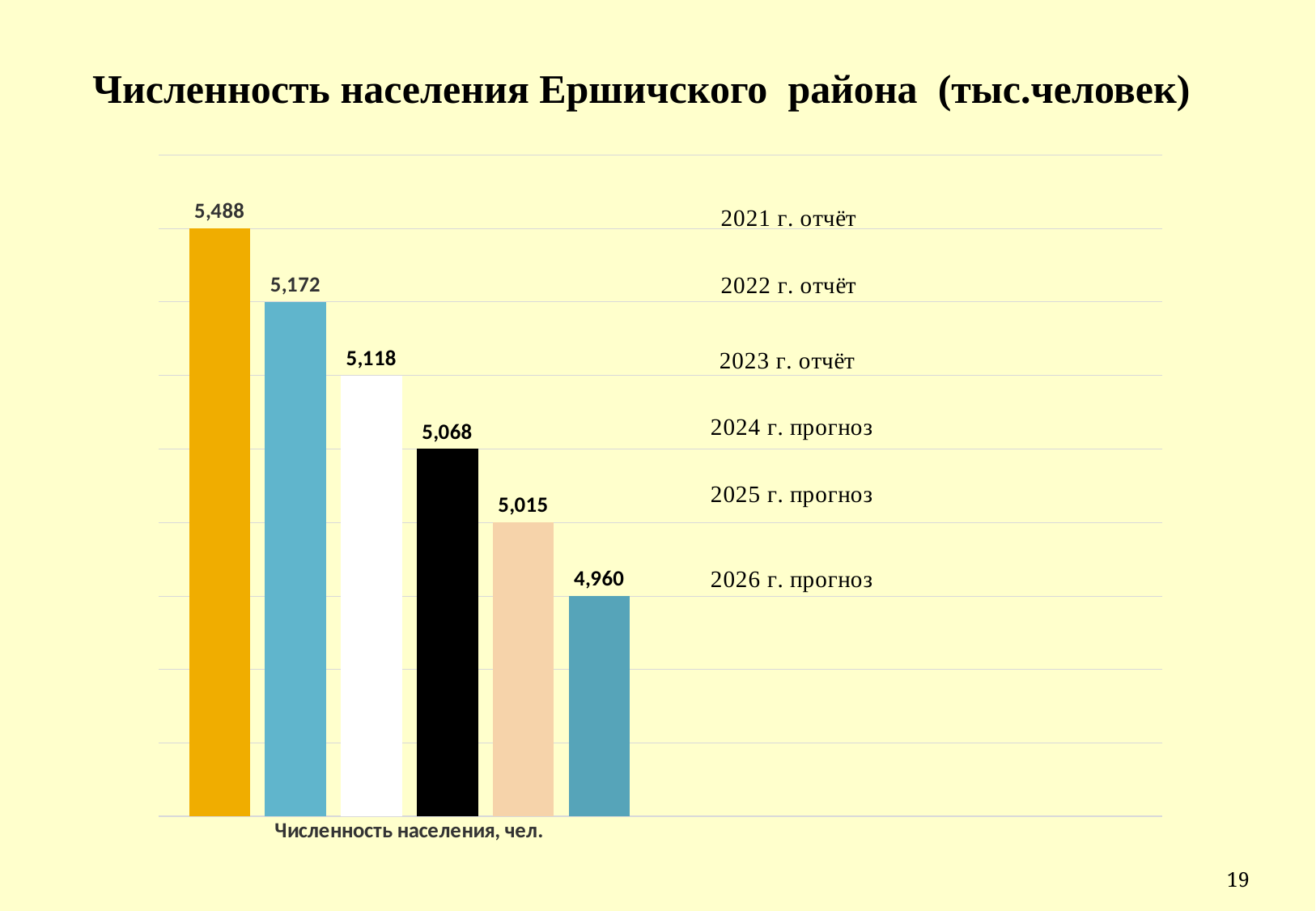
What is the difference between the values for 2021 г. отчёт and 2026 г. прогноз? 528 What type of chart is shown on the slide? bar chart What is the title of the chart? Численность населения Ершичского района (тыс.человек) Which year has the lowest population value in the chart? 2026 г. прогноз Which year has the highest population value in the chart? 2021 г. отчёт Do the population values rise or fall from 2021 to 2026? fall What is the difference between the values for 2021 г. отчёт and 2022 г. отчёт? 316 How many bars are plotted in the chart? 6 Which is larger, the value for 2024 г. прогноз or the value for 2025 г. прогноз? 2024 г. прогноз What is the population value shown for 2026 г. прогноз? 4,960 What is the population value shown for 2021 г. отчёт? 5,488 What is the population value shown for 2023 г. отчёт? 5,118